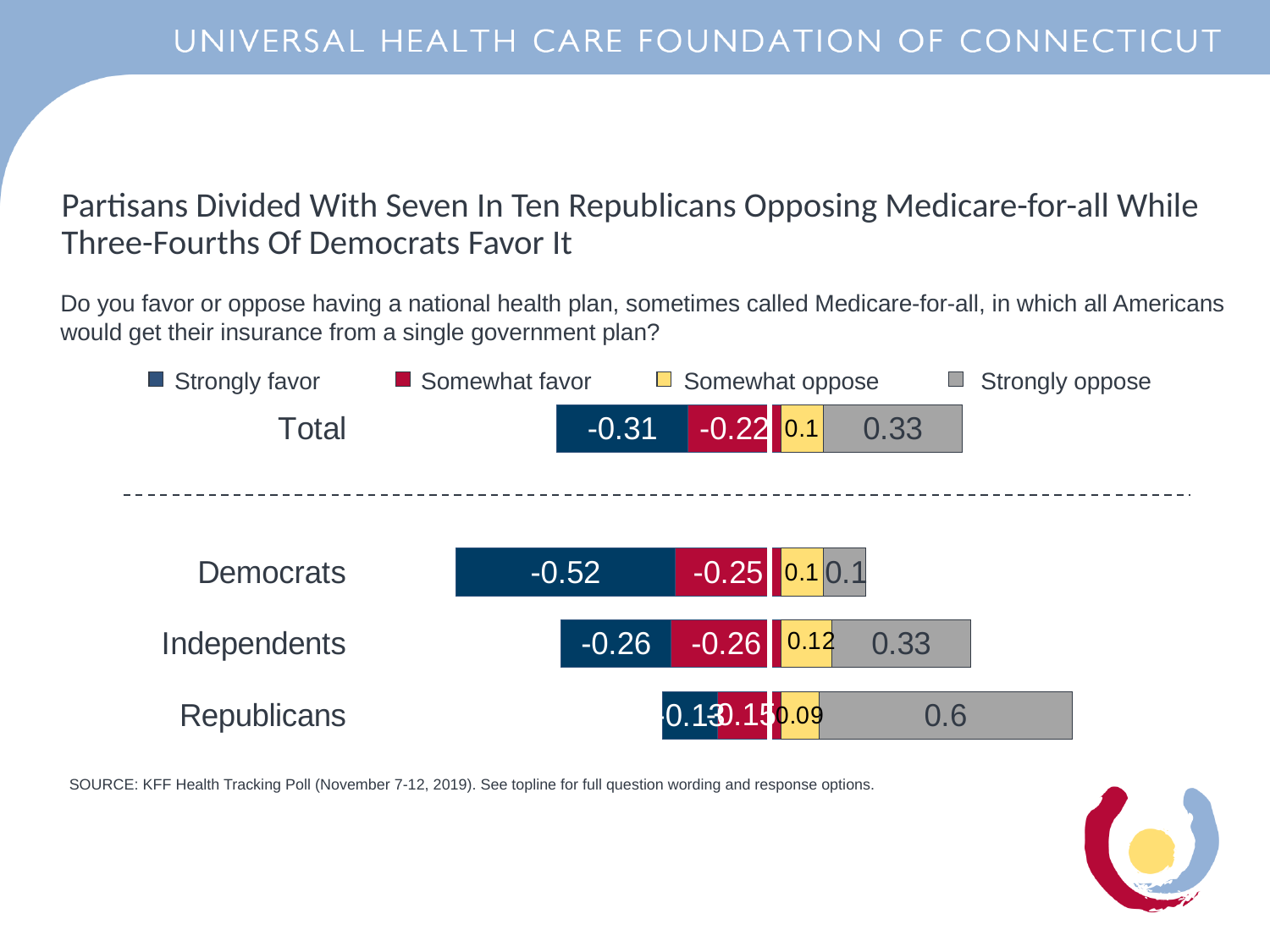
What is the Strongly oppose value for Total? 0.33 Which group has the highest Strongly oppose value? Republicans What is the Somewhat oppose value for Independents? 0.12 How many series does the legend list? 4 Which is larger, the Strongly oppose value for Total or for Democrats? Total What is the difference between the Strongly oppose values for Republicans and Independents? 0.27 How many groups (categories) are plotted in the chart? 4 Which group has the longest Strongly favor bar? Democrats What kind of chart is shown on the slide? bar chart What is the Somewhat favor value for Total? -0.22 What is the Strongly favor value for Democrats? -0.52 What is the Strongly oppose value for Republicans? 0.6